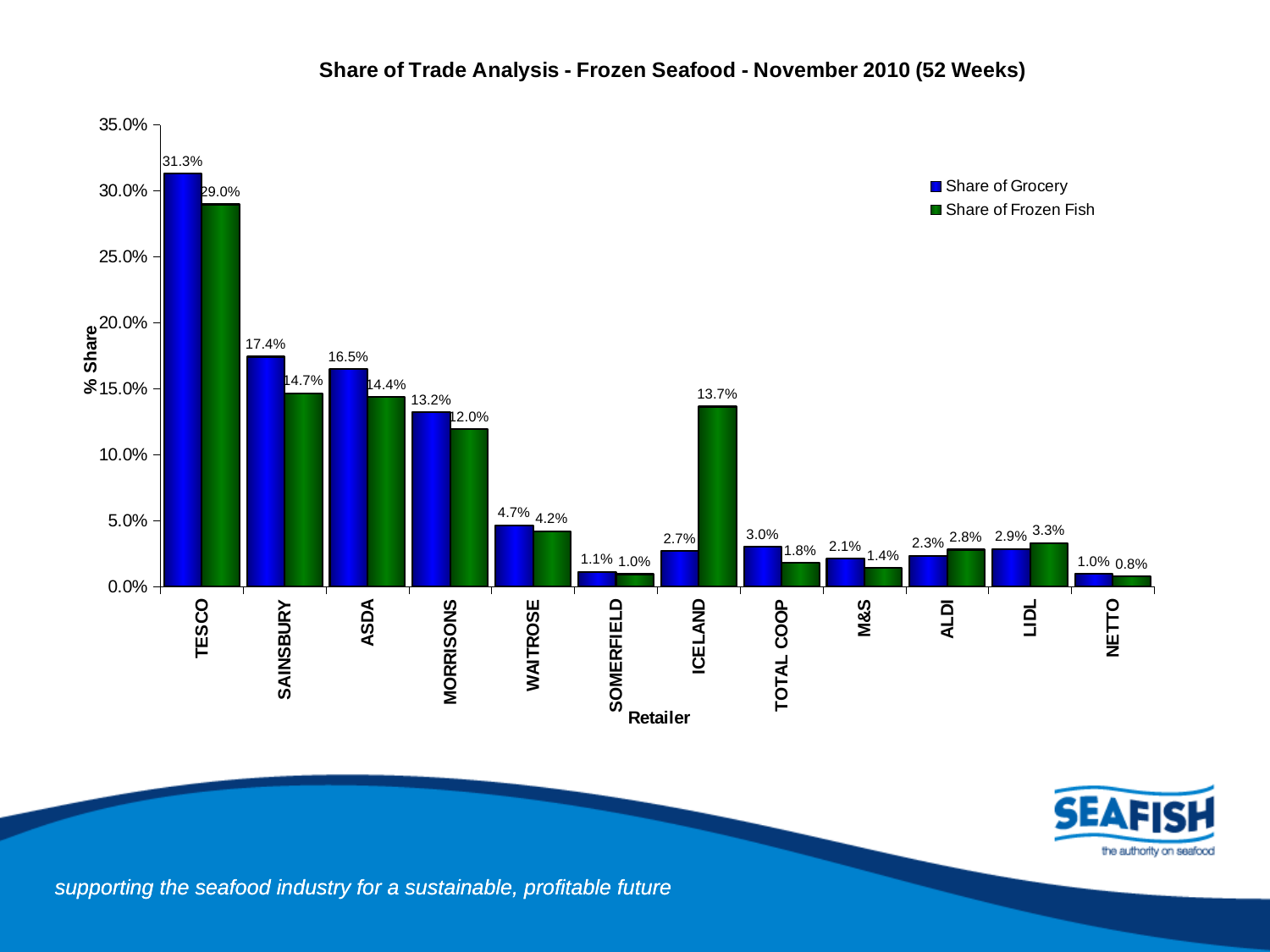
What is the difference between TESCO's Share of Grocery and its Share of Frozen Fish? 2.3% For ICELAND, which is larger: Share of Grocery or Share of Frozen Fish? Share of Frozen Fish How many series does the legend list? 2 What kind of chart is shown on the slide? Bar chart What is the Share of Grocery value for SAINSBURY? 17.4% What is the Share of Frozen Fish value for ICELAND? 13.7% How many retailers are shown on the x axis? 12 Which retailer has the highest Share of Grocery? TESCO Which retailer has the lowest Share of Frozen Fish? NETTO Is the Share of Grocery value for ASDA greater or less than 15.0%? greater What is the Share of Frozen Fish value for MORRISONS? 12.0% What is the title of the chart? Share of Trade Analysis - Frozen Seafood - November 2010 (52 Weeks)